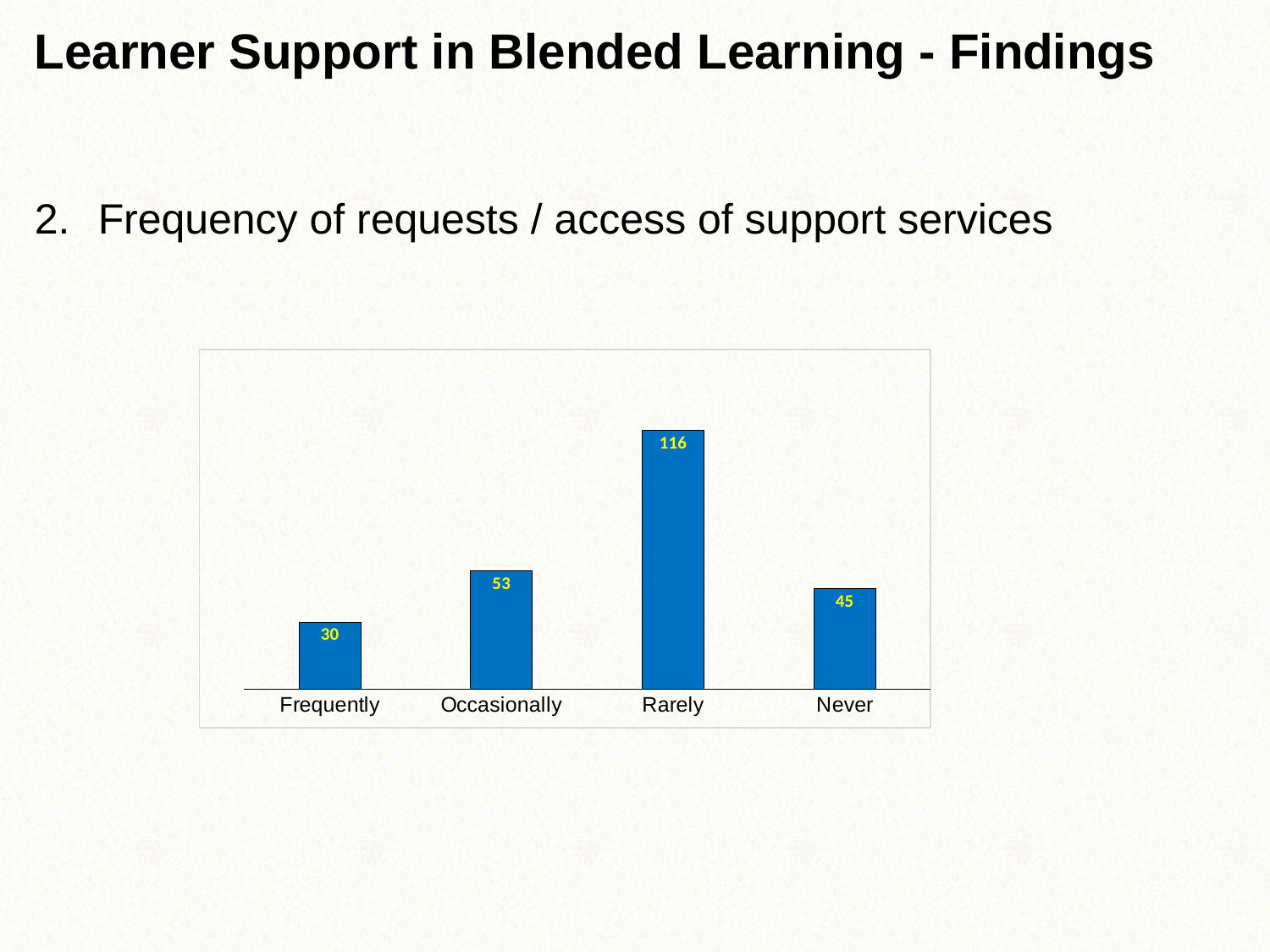
What kind of chart is shown on the slide? Bar chart What colour are the bars in the chart? Blue How many categories are shown on the x axis? 4 What is the value for Occasionally? 53 What is the value for Rarely? 116 Which category has the lowest value? Frequently What is the value for Never? 45 What is the value for Frequently? 30 Which is larger, the value for Occasionally or the value for Never? Occasionally What is the difference between the values for Rarely and Occasionally? 63 What is the difference between the values for Never and Frequently? 15 Which category has the highest value? Rarely